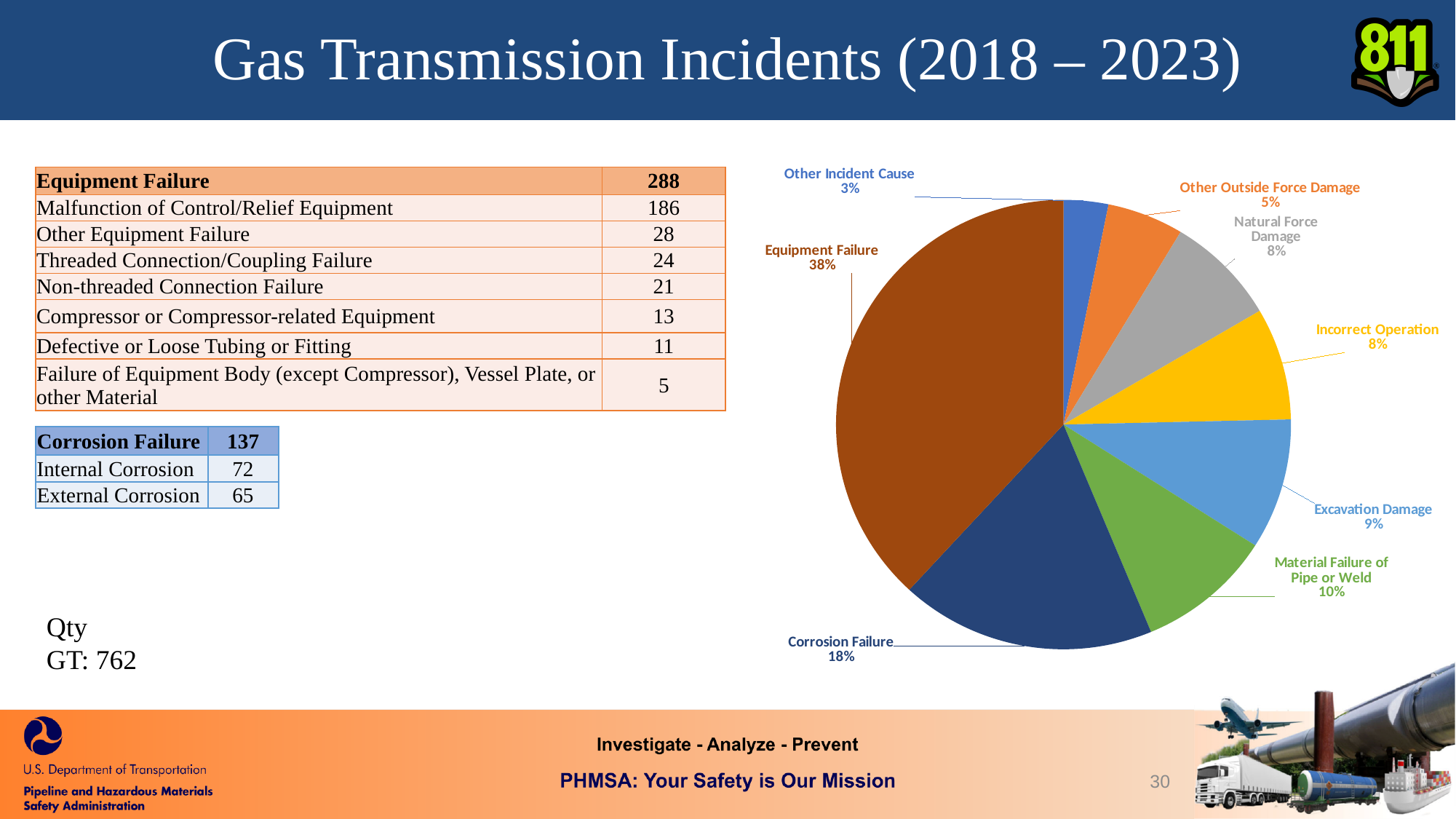
What is the difference in percentage points between Natural Force Damage and Other Incident Cause in the pie chart? 5 What percentage is shown for Material Failure of Pipe or Weld in the pie chart? 10% What kind of chart is shown on the slide? pie chart What is the difference in percentage points between Equipment Failure and Corrosion Failure in the pie chart? 20 How many slices does the pie chart have? 8 Which is larger in the pie chart, Excavation Damage or Other Outside Force Damage? Excavation Damage Which category has the largest slice in the pie chart? Equipment Failure What share of the pie chart does Equipment Failure represent? 38% What share of the pie chart does Corrosion Failure represent? 18% What colour is the Equipment Failure slice in the pie chart? brown What percentage is shown for Excavation Damage in the pie chart? 9% Which category has the smallest slice in the pie chart? Other Incident Cause